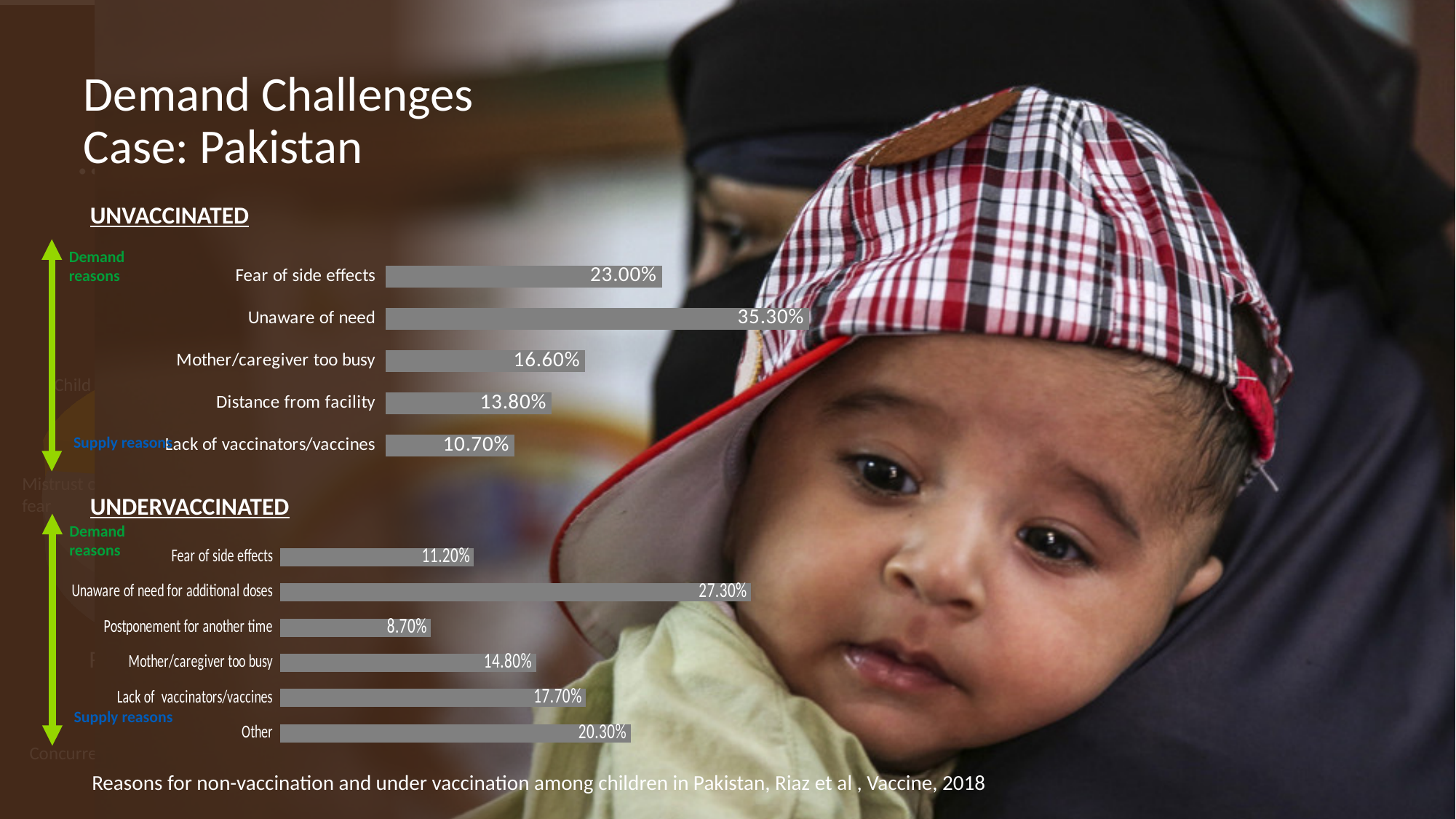
In the UNDERVACCINATED chart, which category has the highest value? Unaware of need for additional doses In the UNVACCINATED chart, which category has the lowest value? Lack of vaccinators/vaccines In the UNVACCINATED chart, what is the difference between Unaware of need and Fear of side effects? 12.30% In the UNDERVACCINATED chart, which is larger: Lack of vaccinators/vaccines or Mother/caregiver too busy? Lack of vaccinators/vaccines In the UNVACCINATED chart, what is the value for Unaware of need? 35.30% What type of chart is the UNVACCINATED chart? Bar chart In the UNVACCINATED chart, how many categories are shown? 5 In the UNDERVACCINATED chart, what is the difference between Lack of vaccinators/vaccines and Fear of side effects? 6.50% In the UNDERVACCINATED chart, what is the value for Other? 20.30% In the UNVACCINATED chart, what is the value for Distance from facility? 13.80% In the UNDERVACCINATED chart, how many categories are shown? 6 In the UNDERVACCINATED chart, what is the value for Postponement for another time? 8.70%